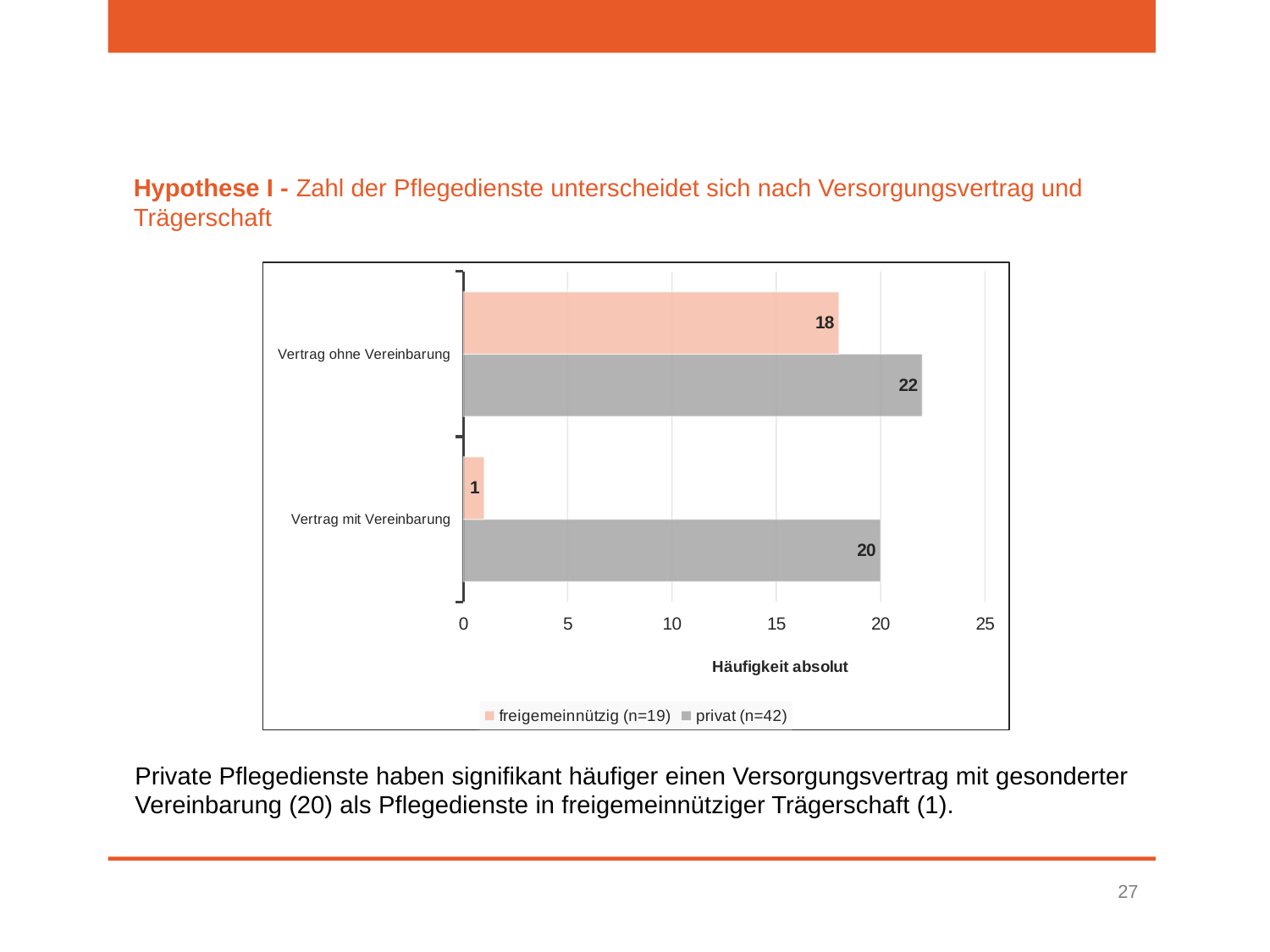
What is the value for freigemeinnützig (n=19) in the category Vertrag mit Vereinbarung? 1 What is the value for privat (n=42) in the category Vertrag mit Vereinbarung? 20 How many series does the legend list? 2 What kind of chart is shown on the slide? Bar chart Which category has the lowest value for the freigemeinnützig (n=19) series? Vertrag mit Vereinbarung How many categories are shown on the chart? 2 What is the value for privat (n=42) in the category Vertrag ohne Vereinbarung? 22 What is the difference between the privat (n=42) and freigemeinnützig (n=19) values for Vertrag ohne Vereinbarung? 4 What is the value for freigemeinnützig (n=19) in the category Vertrag ohne Vereinbarung? 18 Which is larger for Vertrag ohne Vereinbarung: the freigemeinnützig (n=19) value or the privat (n=42) value? privat (n=42) What is the difference between the privat (n=42) and freigemeinnützig (n=19) values for Vertrag mit Vereinbarung? 19 Which category has the highest value for the privat (n=42) series? Vertrag ohne Vereinbarung